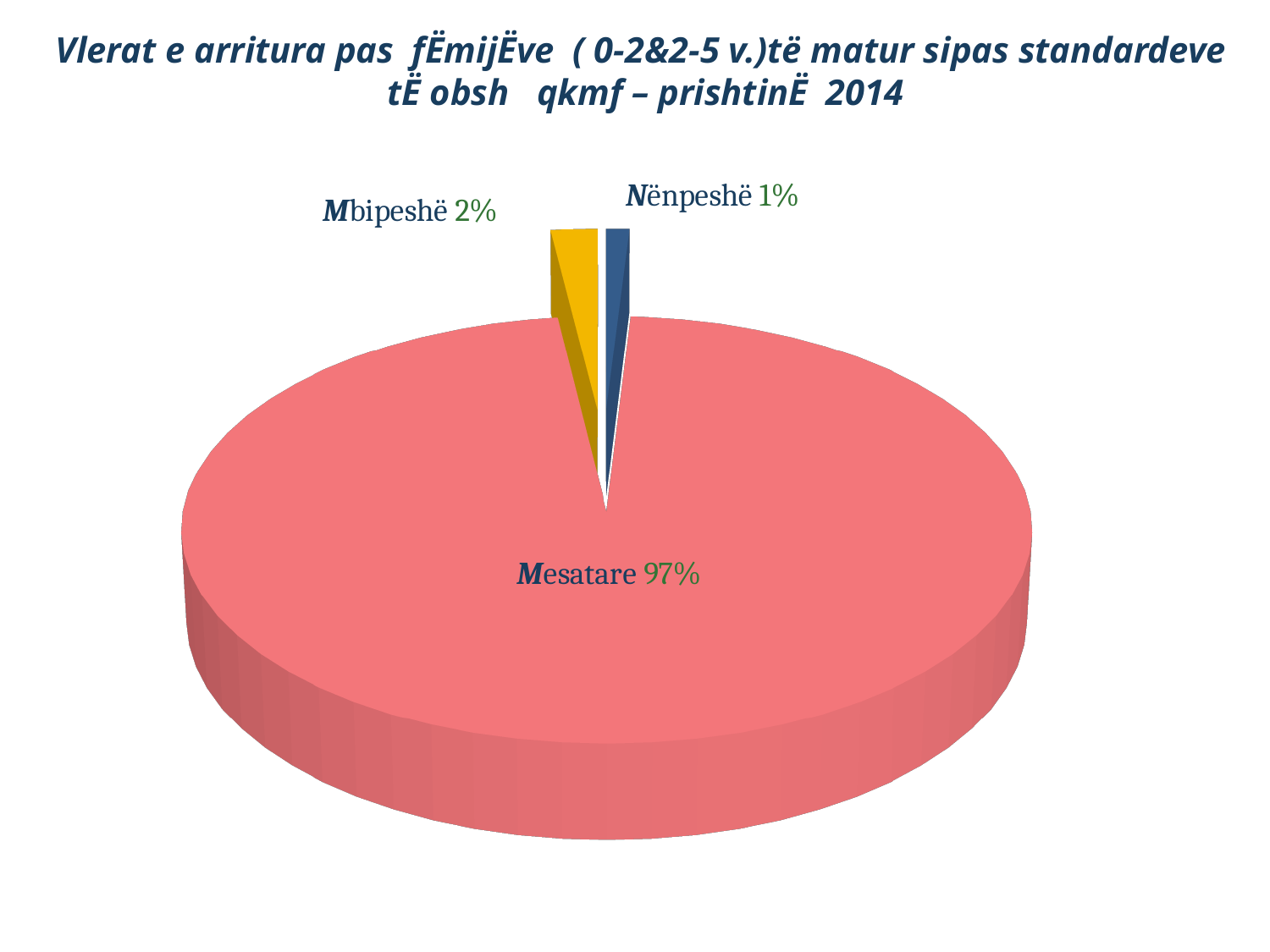
What share of the pie does Mbipeshë represent? 2% What colour is the Mbipeshë slice? yellow What is the difference in percentage points between Mbipeshë and Nënpeshë? 1 What kind of chart is shown on the slide? pie chart What colour is the Mesatare slice? pink/red Which category has the smallest slice of the pie? Nënpeshë Which category has the largest slice of the pie? Mesatare What is the difference in percentage points between Mesatare and Mbipeshë? 95 How many slices does the pie chart have? 3 Which is larger, the Mbipeshë slice or the Nënpeshë slice? Mbipeshë What share of the pie does Mesatare represent? 97% What share of the pie does Nënpeshë represent? 1%